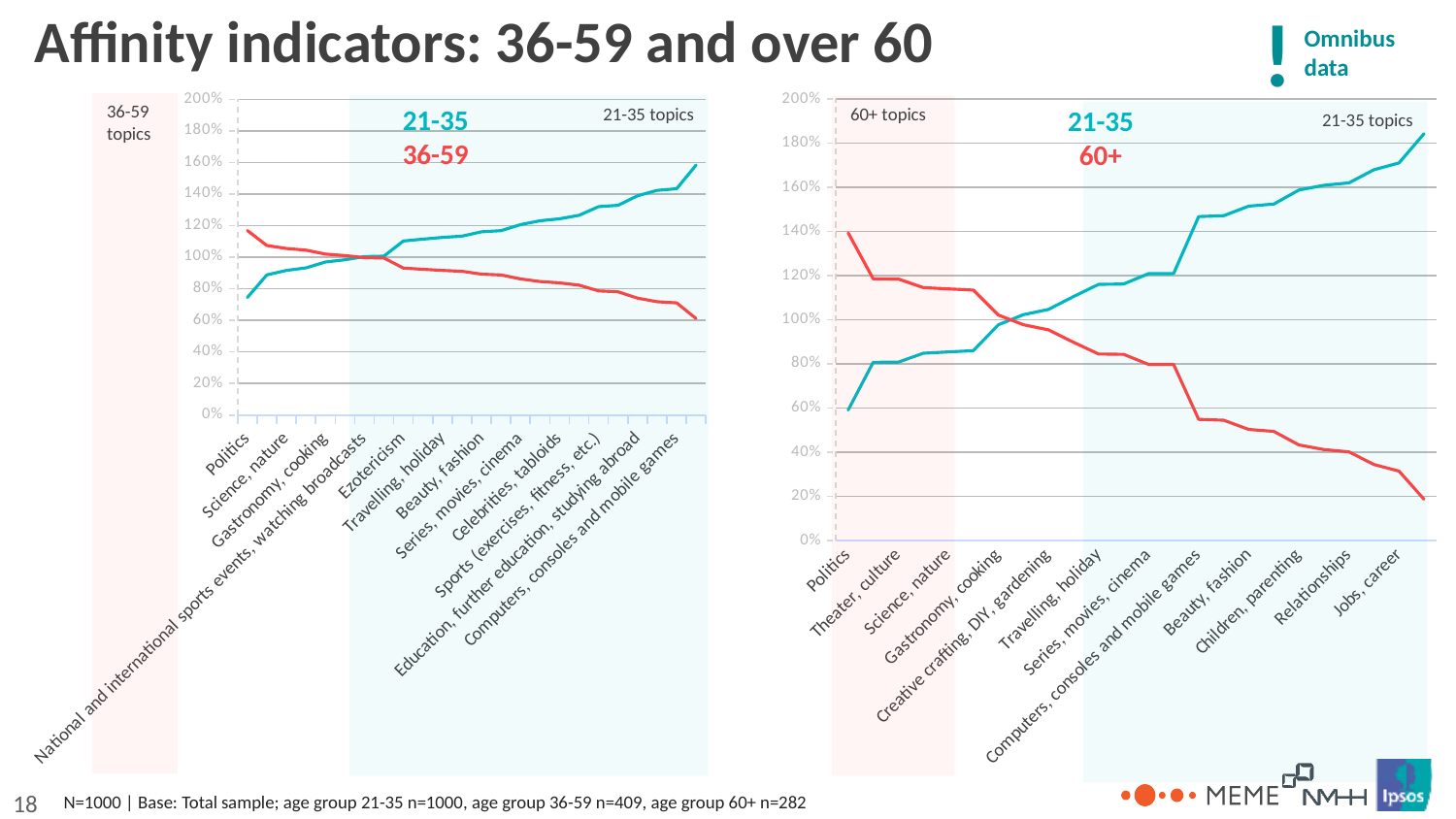
How many topic categories are plotted on the left chart (36-59 and 21-35)? 24 On the right chart, is the 60+ value for Jobs, career greater or less than 40%? less On the right chart, is the 21-35 value for Politics greater or less than 80%? less How many series does the right chart (60+ and 21-35) show? 2 How many topic categories are plotted on the right chart (60+ and 21-35)? 24 On the left chart, is the 36-59 value for Politics greater or less than 100%? greater On the left chart, which series has the higher value for Politics: 21-35 or 36-59? 36-59 What type of chart is the left chart (36-59 and 21-35)? line chart On the right chart, which series has the higher value for Jobs, career: 21-35 or 60+? 21-35 On the left chart, does the 21-35 line rise or fall from Politics to Computers, consoles and mobile games? rise On the right chart, does the 60+ line rise or fall from Politics to Jobs, career? fall